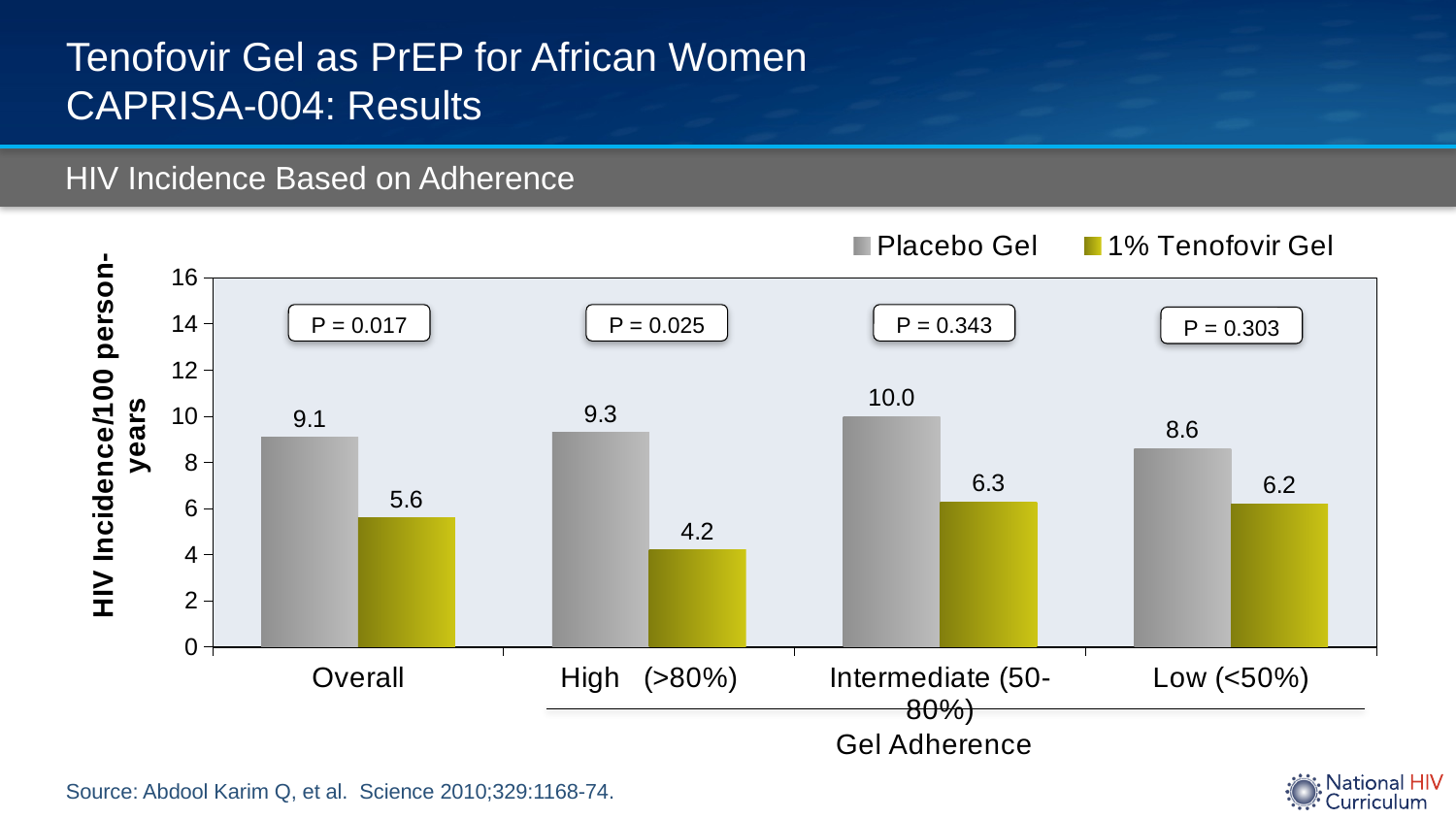
In the Intermediate (50-80%) adherence category, which group has the higher HIV incidence, Placebo Gel or 1% Tenofovir Gel? Placebo Gel What is the HIV incidence per 100 person-years for the Placebo Gel group in the Overall category? 9.1 Which adherence category has the highest Placebo Gel HIV incidence? Intermediate (50-80%) What is the difference between the Placebo Gel and 1% Tenofovir Gel HIV incidence in the Overall category? 3.5 What P value is shown for the Low (<50%) adherence category? P = 0.303 How many series does the legend list? 2 What kind of chart is shown on the slide? Bar chart What is the difference between the Placebo Gel and 1% Tenofovir Gel HIV incidence in the High (>80%) adherence category? 5.1 What is the HIV incidence per 100 person-years for the 1% Tenofovir Gel group in the Low (<50%) adherence category? 6.2 Which category has the lowest 1% Tenofovir Gel HIV incidence? High (>80%) How many adherence categories are shown on the x axis? 4 What is the HIV incidence per 100 person-years for the 1% Tenofovir Gel group in the High (>80%) adherence category? 4.2